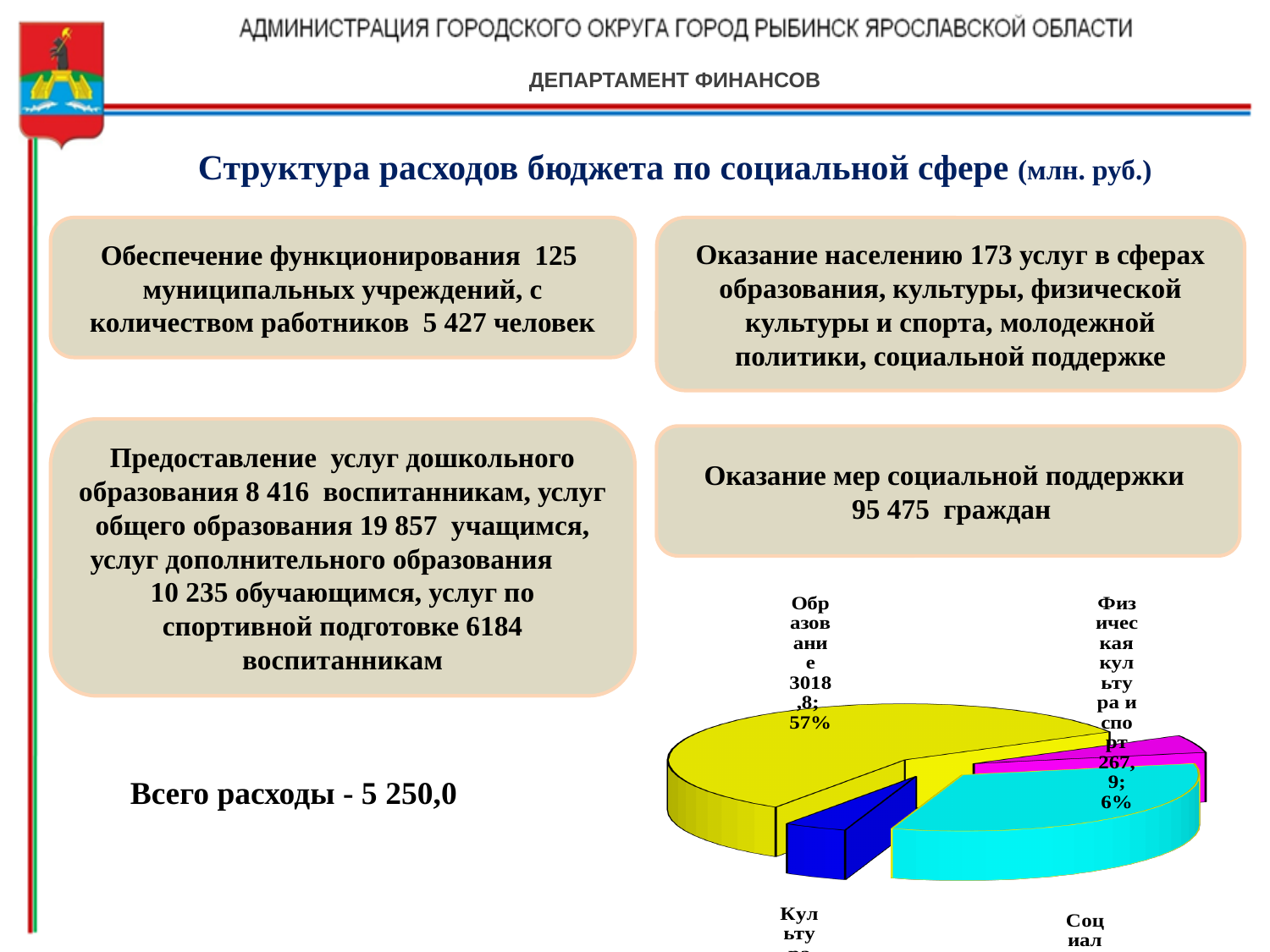
Is the share of Образование greater or less than 50%? greater Which is larger, the value for Образование or the value for Физическая культура и спорт? Образование What is the difference between the values for Образование and Физическая культура и спорт? 2750,9 What value is shown for Физическая культура и спорт in the pie chart? 267,9 What colour is the Образование slice in the pie chart? yellow What share of the pie does Образование account for? 57% Which category has the largest slice in the pie chart? Образование What value is shown for Образование in the pie chart? 3018,8 What kind of chart is shown on the slide? pie chart How many slices does the pie chart have? 4 By how many percentage points does the share of Образование exceed the share of Физическая культура и спорт? 51% What share of the pie does Физическая культура и спорт account for? 6%